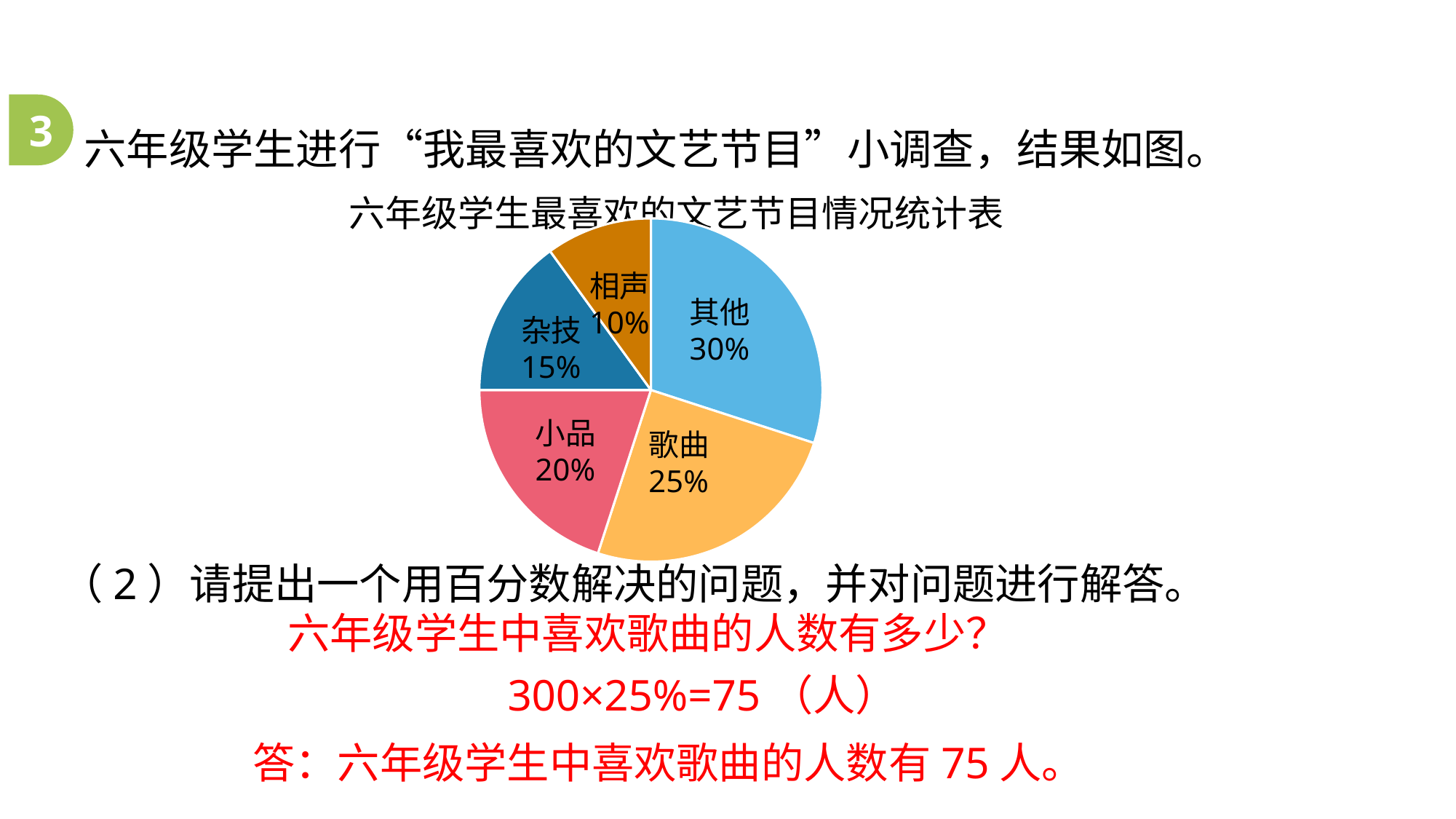
What is the difference in percentage points between 其他 and 相声? 20 Which is larger, the share for 小品 or the share for 杂技? 小品 What percentage of the pie chart is 歌曲? 25% What percentage of the pie chart is 杂技? 15% Which category has the largest share of the pie chart? 其他 What is the title of the pie chart? 六年级学生最喜欢的文艺节目情况统计表 What percentage of the pie chart is 相声? 10% Which category has the smallest share of the pie chart? 相声 What kind of chart is shown on the slide? pie chart How many categories are shown in the pie chart? 5 What percentage of the pie chart is 小品? 20% What is the combined share of 歌曲 and 小品? 45%